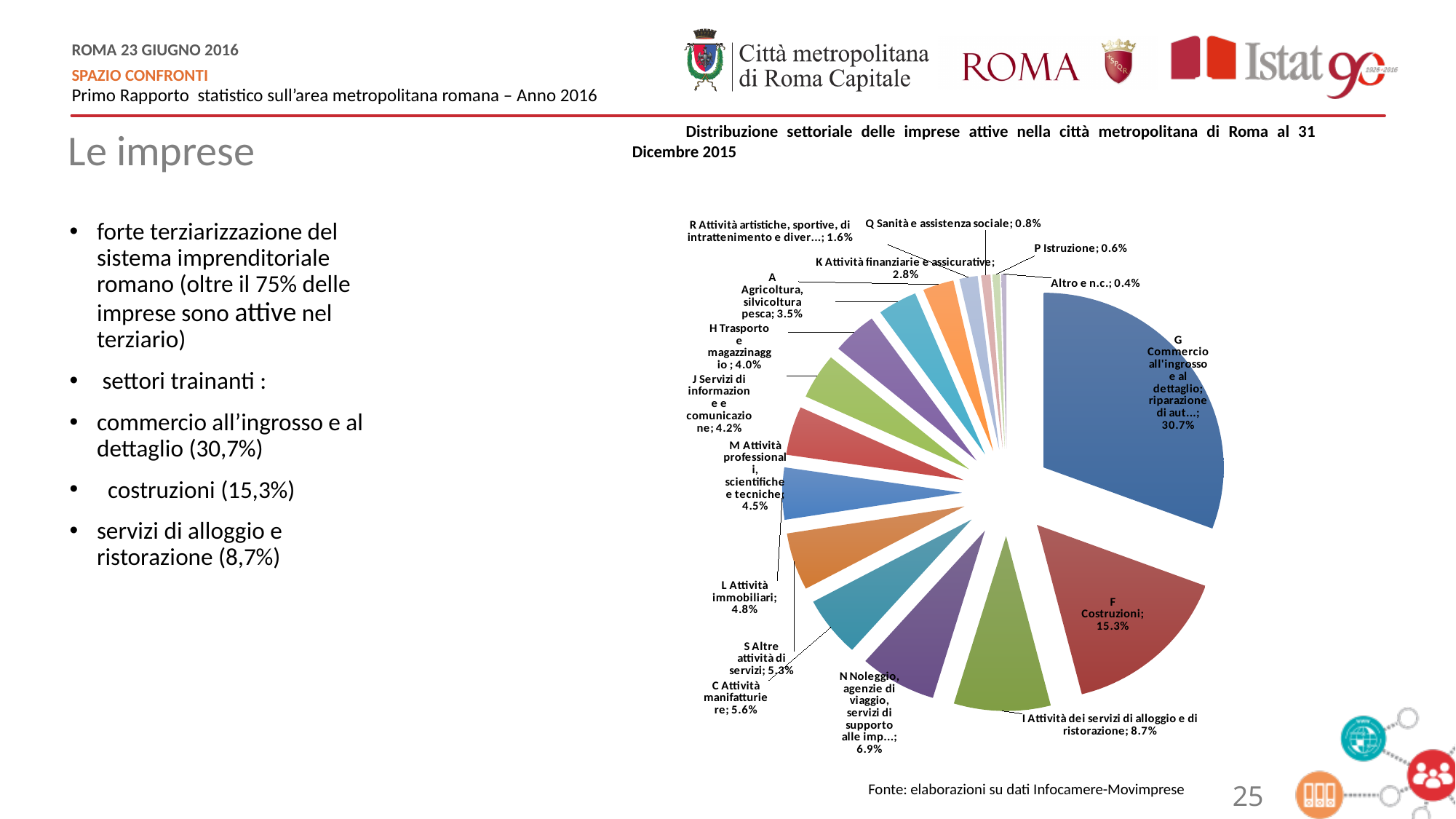
Which has a larger share: L Attività immobiliari or M Attività professionali, scientifiche e tecniche? L Attività immobiliari What percentage is shown for C Attività manifatturiere? 5.6% What is the share for K Attività finanziarie e assicurative? 2.8% What is the difference in percentage points between G Commercio all'ingrosso e al dettaglio (30.7%) and F Costruzioni (15.3%)? 15.4 What is the share for I Attività dei servizi di alloggio e di ristorazione? 8.7% What is the title of the pie chart? Distribuzione settoriale delle imprese attive nella città metropolitana di Roma al 31 Dicembre 2015 Which sector has the largest share of active enterprises in the pie chart? G Commercio all'ingrosso e al dettaglio; riparazione di aut... How many slices does the pie chart have? 16 What is the share for P Istruzione? 0.6% Which slice of the pie chart has the smallest share? Altro e n.c. What kind of chart is shown on the slide? pie chart What share of active enterprises does F Costruzioni represent? 15.3%